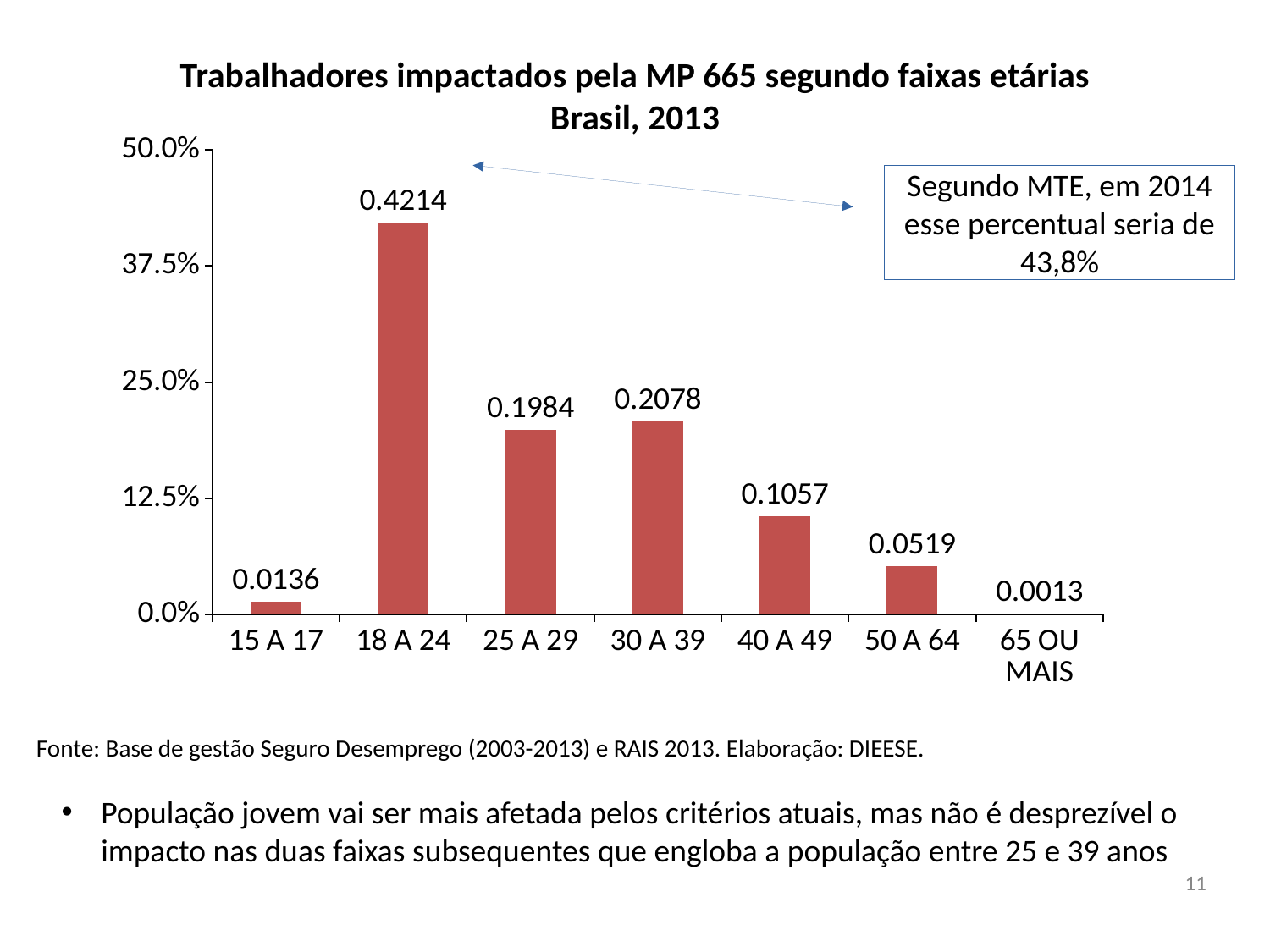
What is the title of the chart? Trabalhadores impactados pela MP 665 segundo faixas etárias Brasil, 2013 Which is larger, the value for 50 A 64 or the value for 15 A 17? 50 A 64 What is the value shown for the 18 A 24 age group? 0.4214 What is the value shown for the 65 OU MAIS age group? 0.0013 Is the bar for 18 A 24 above or below the 37.5% axis line? above What kind of chart is shown on the slide? bar chart What is the value shown for the 40 A 49 age group? 0.1057 Which age group has the lowest value? 65 OU MAIS According to the text box on the chart, what would the percentage be in 2014 according to MTE? 43,8% What is the difference between the values for 30 A 39 and 25 A 29? 0.0094 Which age group has the highest value? 18 A 24 How many age groups are shown on the x axis? 7